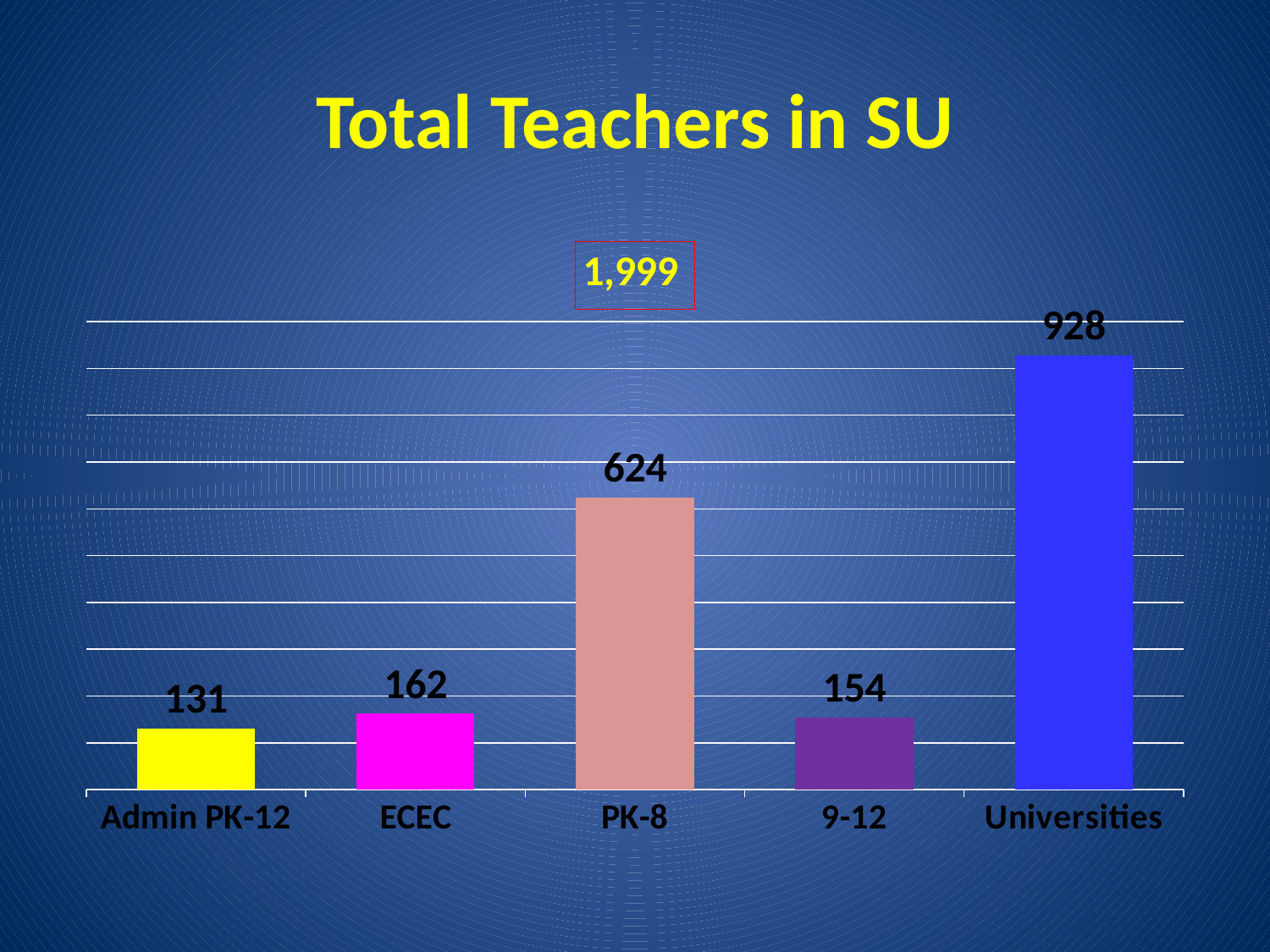
How many categories are shown on the x axis? 5 What is the value for ECEC? 162 What is the value for Admin PK-12? 131 Which category has the highest value? Universities Which is larger, the value for ECEC or the value for 9-12? ECEC What is the title of the chart? Total Teachers in SU What is the value for PK-8? 624 What is the difference between the values for Universities and PK-8? 304 What is the value for Universities? 928 Which category has the lowest value? Admin PK-12 What kind of chart is shown on the slide? Bar chart What is the difference between the values for ECEC and 9-12? 8